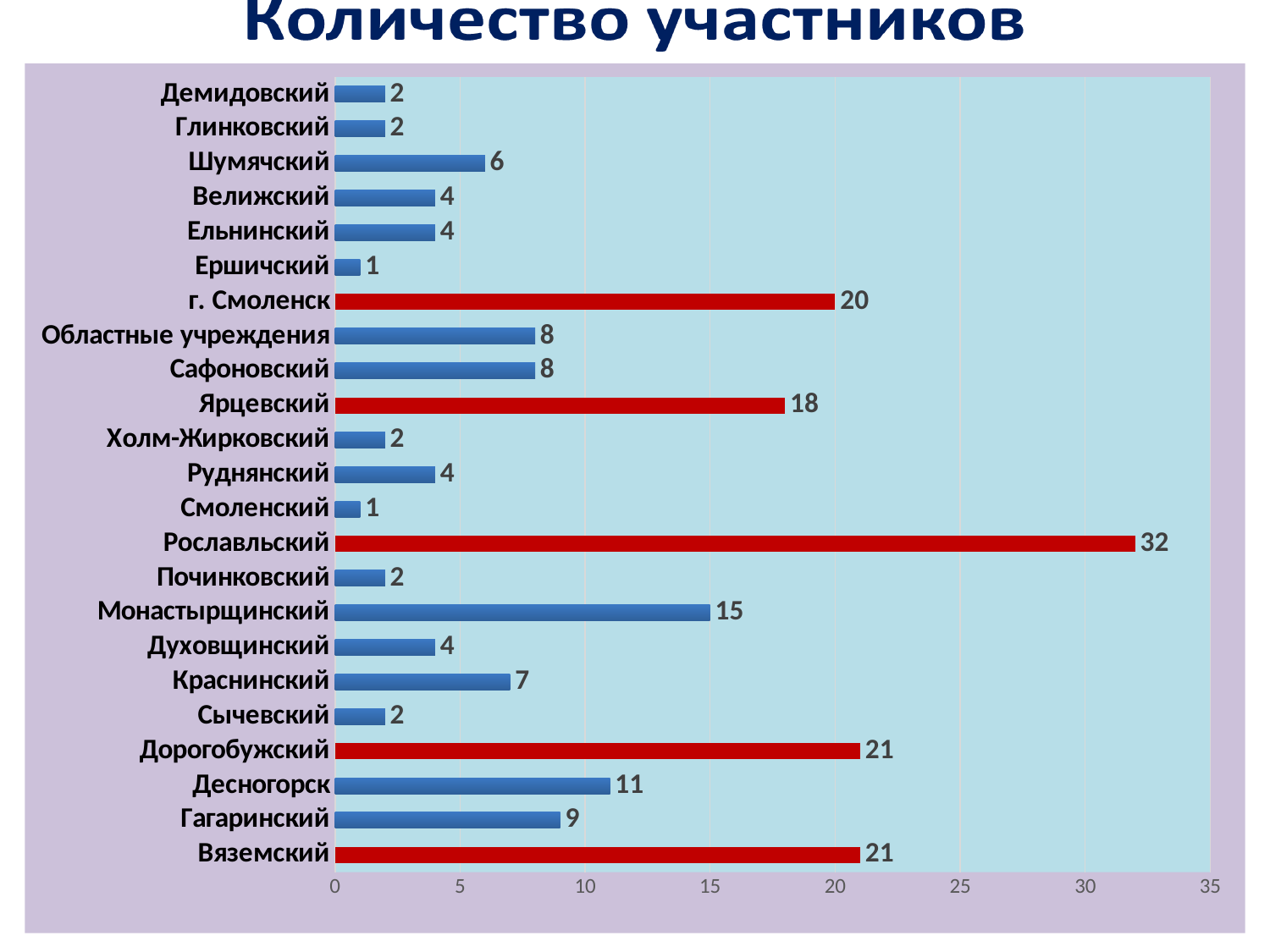
How many bars are coloured red in the chart? 5 What is the value for Рославльский? 32 Which is larger, the value for Ярцевский or the value for Гагаринский? Ярцевский What is the value for Десногорск? 11 What is the value for г. Смоленск? 20 What is the difference between the values for Вяземский and Десногорск? 10 Which category has the highest number of participants? Рославльский What kind of chart is shown on the slide? bar chart What is the difference between the values for Рославльский and Дорогобужский? 11 How many categories are plotted in the chart? 23 What is the value for Монастырщинский? 15 What is the title of the chart? Количество участников